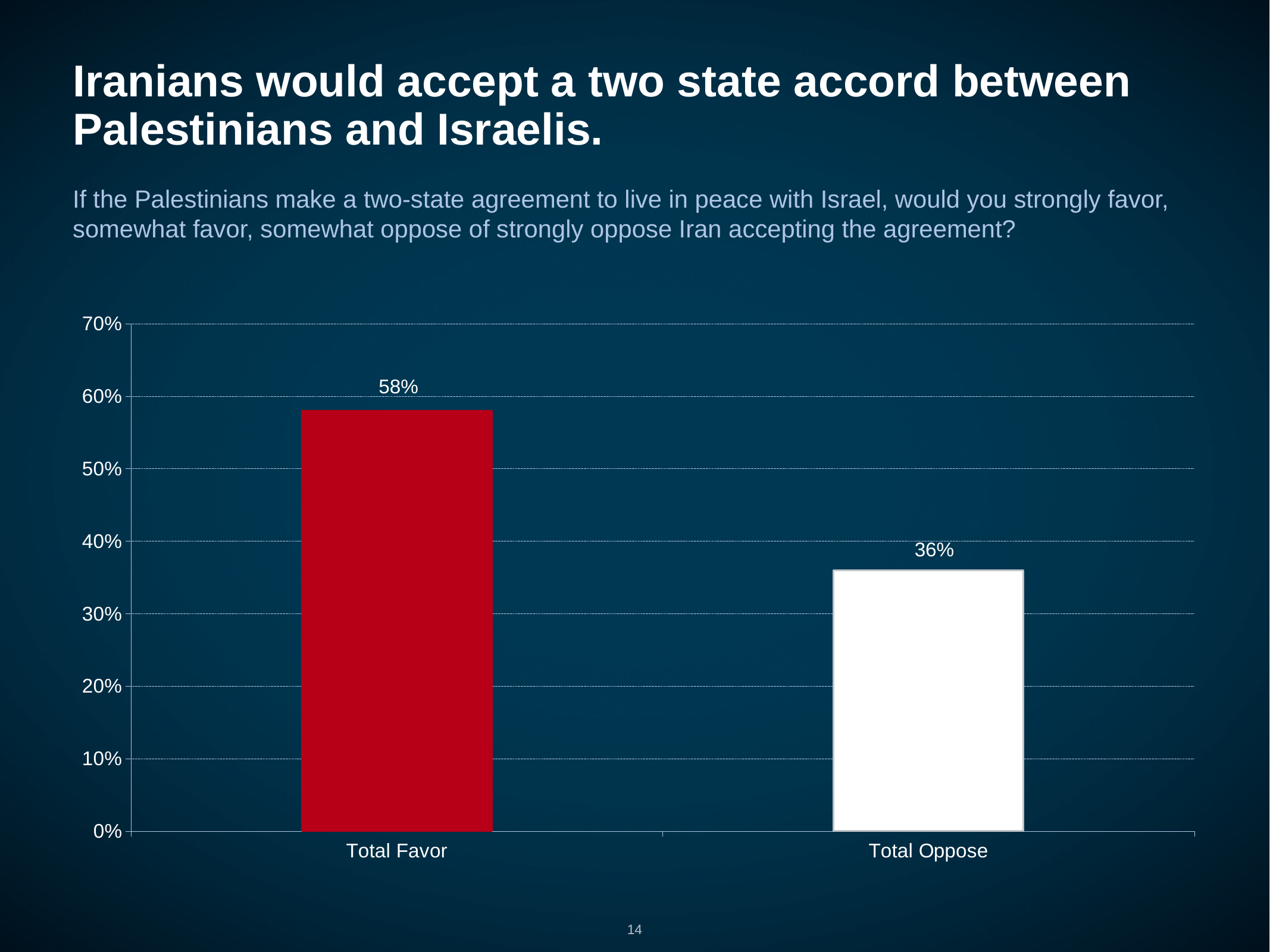
What kind of chart is shown on the slide? bar chart Which category has the lowest value? Total Oppose Is the value for Total Favor greater or less than 50%? greater What is the difference between Total Favor and Total Oppose? 22% What is the highest value shown on the vertical axis? 70% What colour is the Total Favor bar? red Which category has the highest value? Total Favor How many categories are shown on the chart? 2 Is the value for Total Oppose greater or less than 40%? less What is the value for Total Oppose? 36% Which is larger, Total Favor or Total Oppose? Total Favor What is the value for Total Favor? 58%